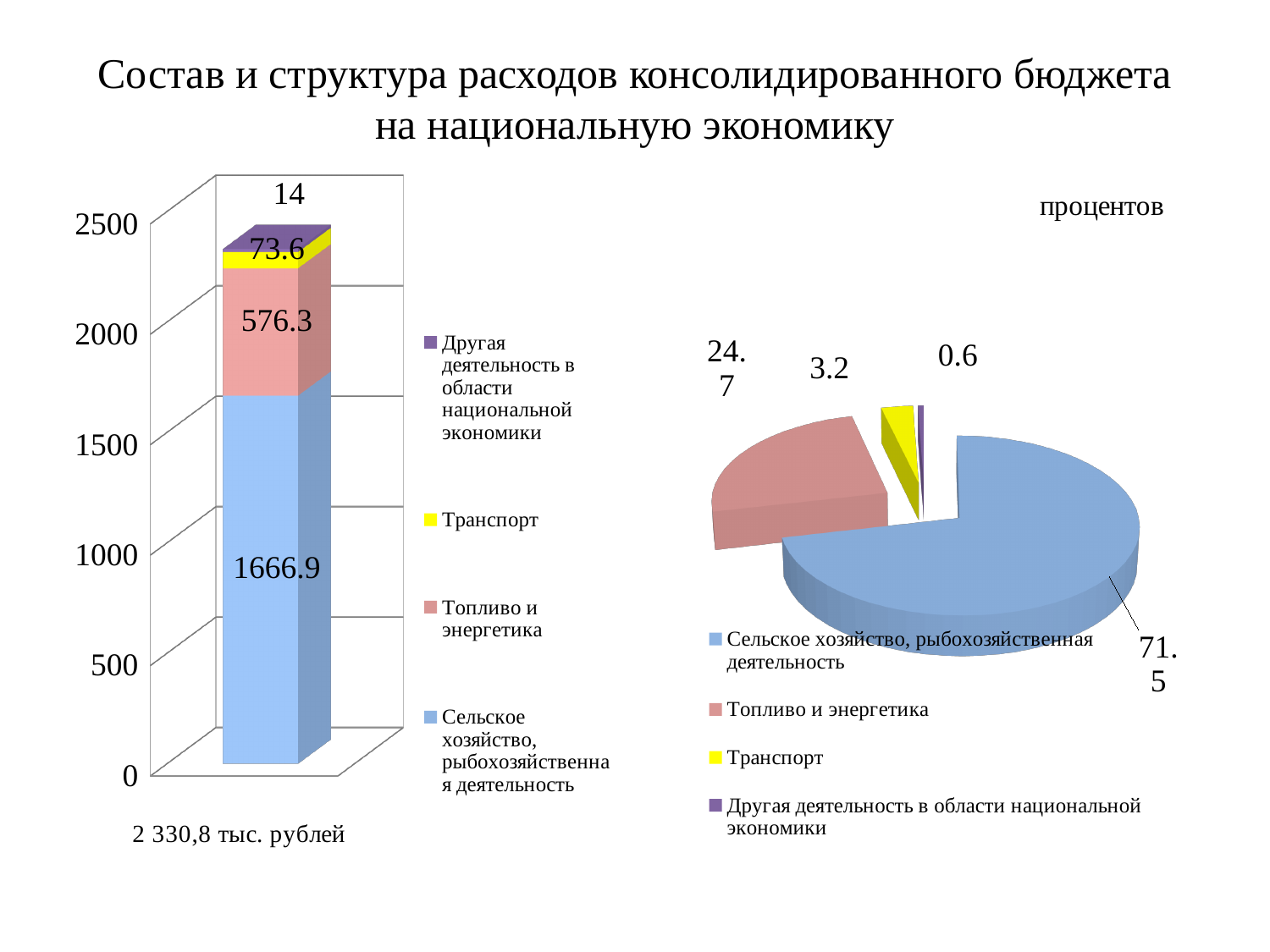
On the left stacked bar chart, what is the value for Топливо и энергетика? 576.3 On the left stacked bar chart, what is the value for Сельское хозяйство, рыбохозяйственная деятельность? 1666.9 On the right pie chart, what is the value for Топливо и энергетика? 24.7 On the left stacked bar chart, which series has the largest segment? Сельское хозяйство, рыбохозяйственная деятельность On the right pie chart, which category has the smallest slice? Другая деятельность в области национальной экономики On the left stacked bar chart, what is the value for Транспорт? 73.6 On the right pie chart, which is larger: Транспорт or Другая деятельность в области национальной экономики? Транспорт What kind of chart is the chart on the left of the slide? Stacked bar chart On the left stacked bar chart, what is the difference between Топливо и энергетика and Транспорт? 502.7 On the left stacked bar chart, how many series does the legend list? 4 On the left stacked bar chart, what is the value for Другая деятельность в области национальной экономики? 14 On the right pie chart, what share does Сельское хозяйство, рыбохозяйственная деятельность have? 71.5